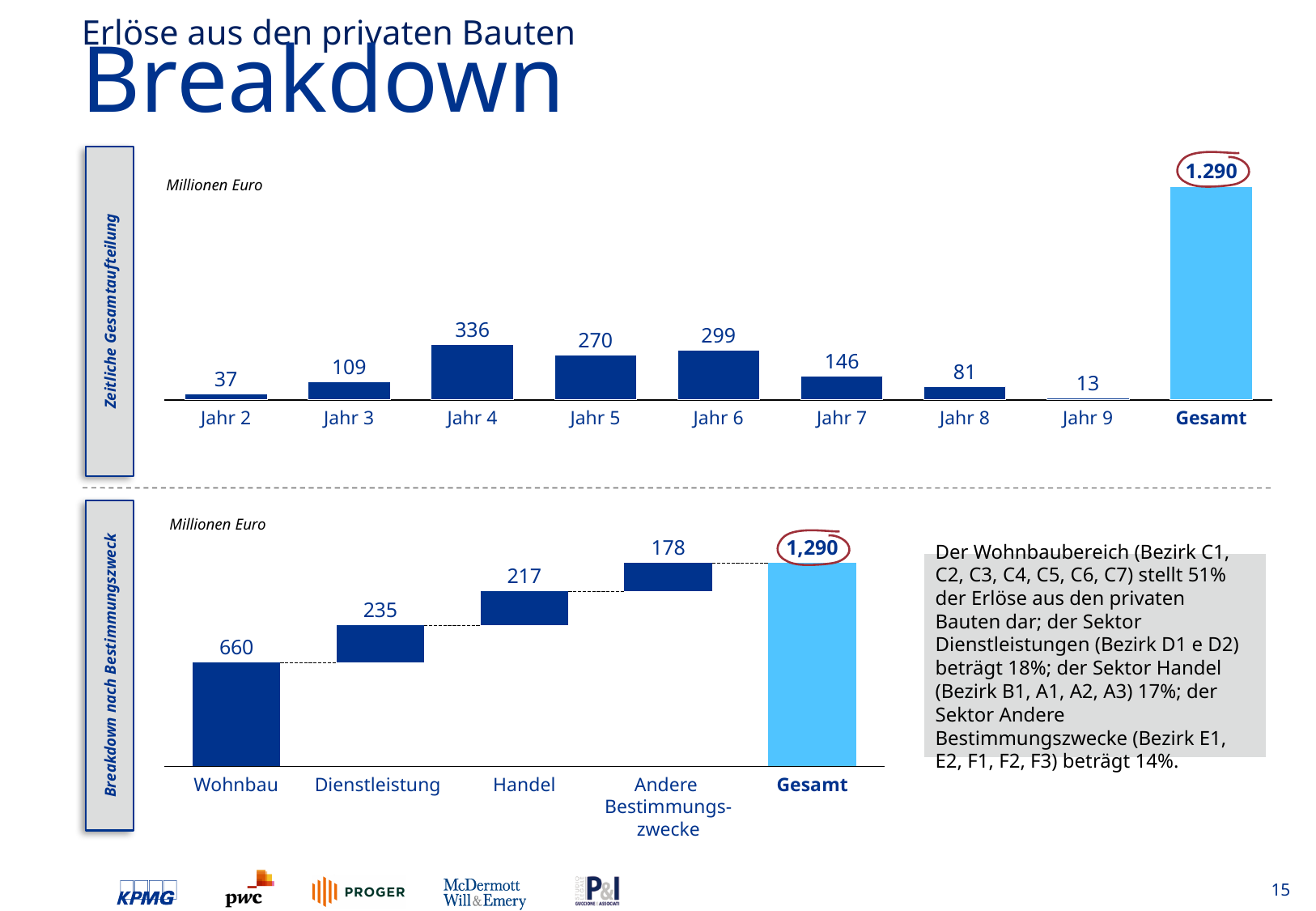
In the bottom chart (Breakdown nach Bestimmungszweck), which category has the lowest value, excluding Gesamt? Andere Bestimmungszwecke In the top chart (Zeitliche Gesamtaufteilung), which year has the highest value? Jahr 4 What unit is stated for the values in both charts? Millionen Euro In the top chart (Zeitliche Gesamtaufteilung), which is larger, Jahr 3 or Jahr 8? Jahr 3 In the top chart (Zeitliche Gesamtaufteilung), how many year categories are shown, excluding Gesamt? 8 In the top chart (Zeitliche Gesamtaufteilung), what is the value shown for Gesamt? 1.290 In the bottom chart (Breakdown nach Bestimmungszweck), what is the value for Wohnbau? 660 In the top chart (Zeitliche Gesamtaufteilung), what is the value for Jahr 7? 146 In the top chart (Zeitliche Gesamtaufteilung), what is the value for Jahr 4? 336 In the top chart (Zeitliche Gesamtaufteilung), which year has the lowest value? Jahr 9 In the top chart (Zeitliche Gesamtaufteilung), what is the difference between Jahr 6 and Jahr 5? 29 In the bottom chart (Breakdown nach Bestimmungszweck), what is the difference between Dienstleistung and Handel? 18